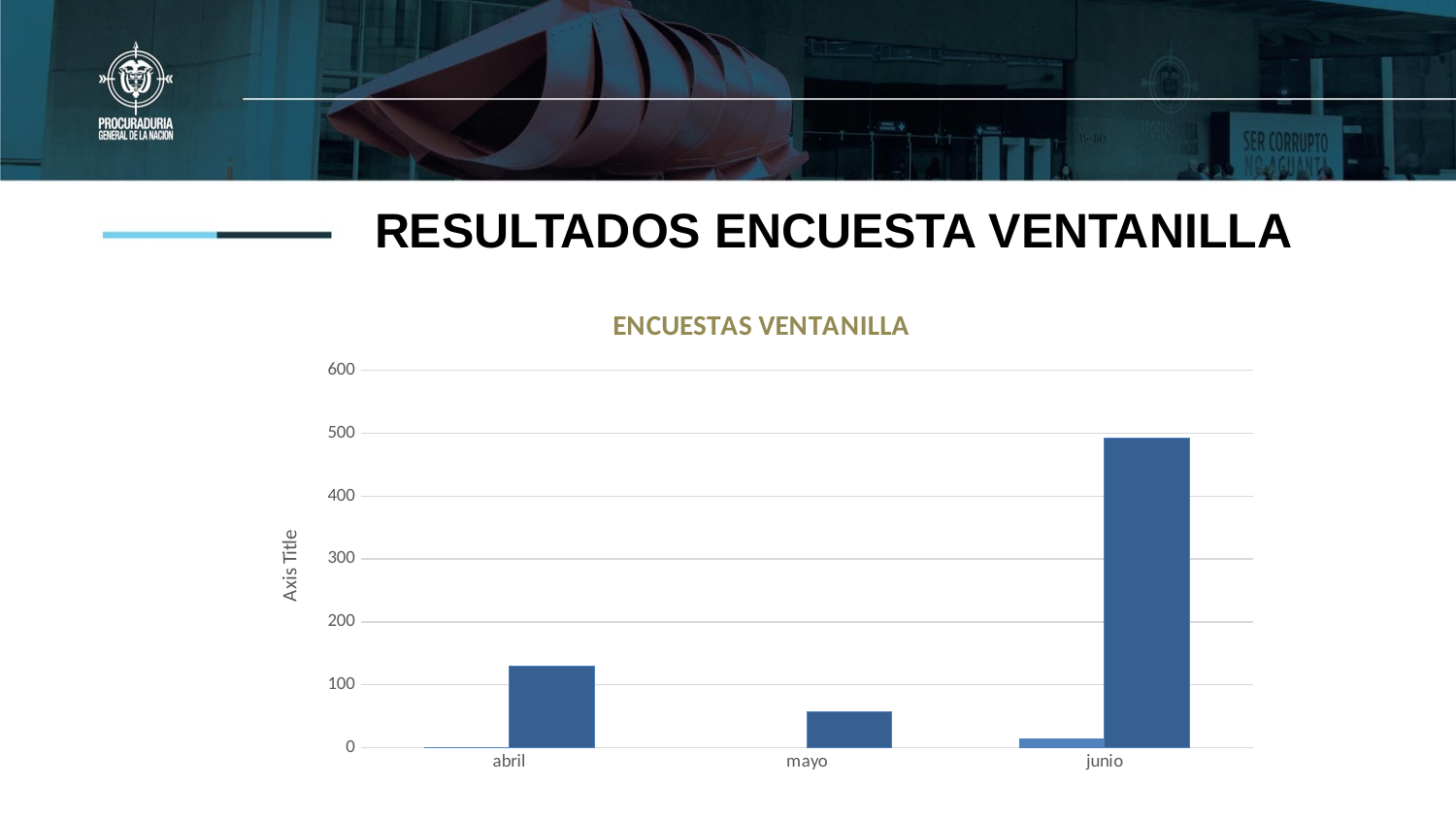
What kind of chart is shown on the slide? bar chart What label is shown on the vertical axis of the chart? Axis Title How many categories are shown on the x axis of the chart? 3 Does the value of the tallest bar rise or fall from mayo to junio? rise Is the value of the tallest bar for mayo greater or less than 100? less Is the value of the tallest bar for abril greater or less than 100? greater What is the title of the chart? ENCUESTAS VENTANILLA Which category has the tallest bar in the chart? junio Among the taller bars for each month, which month has the lowest value? mayo Is the value of the tallest bar for junio greater or less than 400? greater Which has the larger tallest bar, abril or mayo? abril